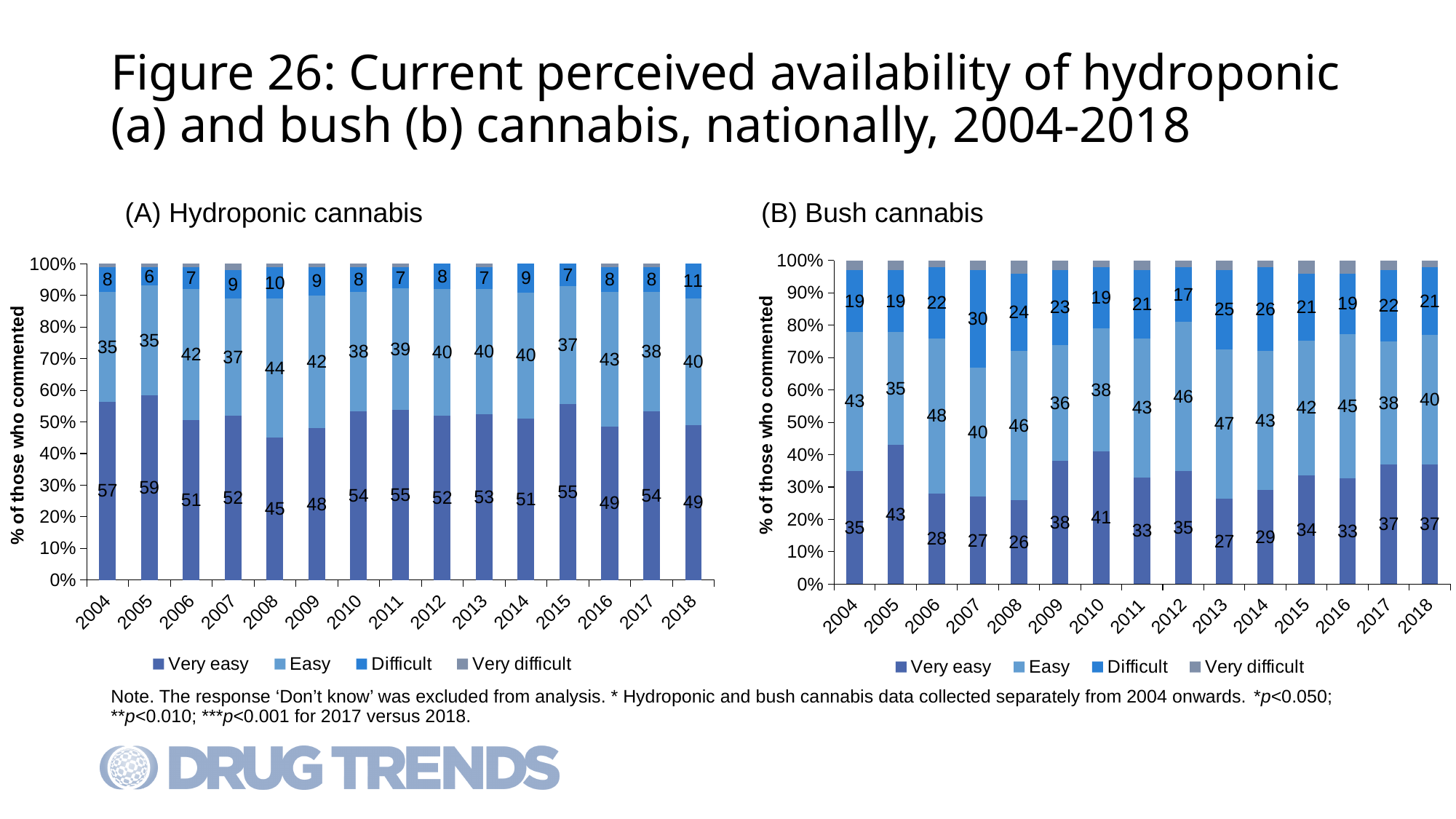
What kind of chart is the (B) Bush cannabis chart? Stacked bar chart In the (A) Hydroponic cannabis chart, what is the difference between the 'Very easy' values for 2005 and 2008? 14 In the (B) Bush cannabis chart, is the 'Easy' value larger in 2006 or in 2009? 2006 In the (B) Bush cannabis chart, which year has the highest 'Difficult' value? 2007 How many years are shown on the x axis of the (B) Bush cannabis chart? 15 What is the y-axis label of the (A) Hydroponic cannabis chart? % of those who commented How many series does the legend of the (A) Hydroponic cannabis chart list? 4 In the (B) Bush cannabis chart, which year has the lowest 'Very easy' value? 2008 In the (B) Bush cannabis chart, what is the 'Difficult' value for 2007? 30 In the (A) Hydroponic cannabis chart, which year has the lowest 'Very easy' value? 2008 In the (A) Hydroponic cannabis chart, what percentage reported 'Very easy' in 2005? 59 In the (A) Hydroponic cannabis chart, which year has the highest 'Very easy' value? 2005